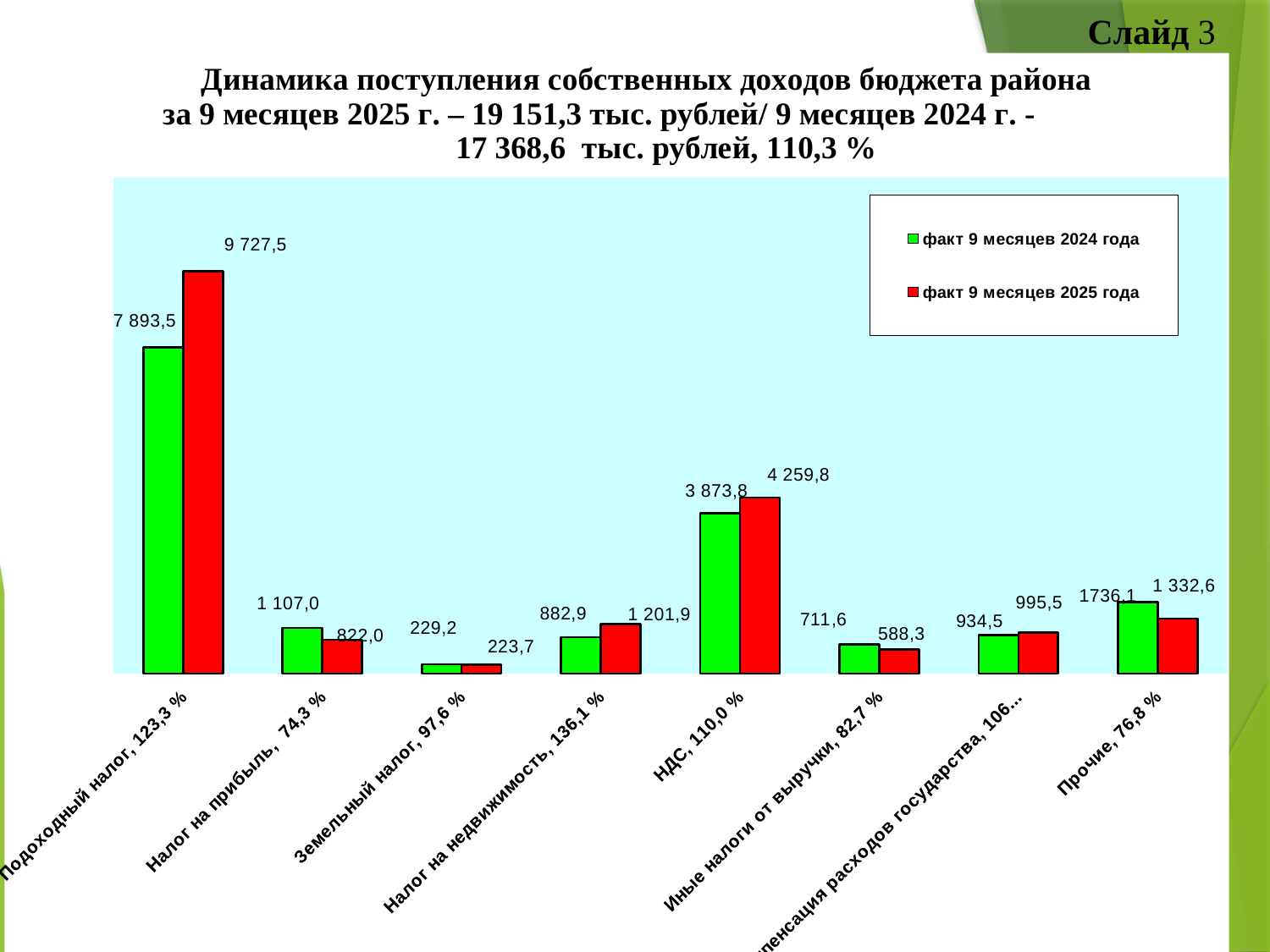
What is the difference between the 2025 and 2024 values for "Подоходный налог"? 1 834,0 Which category has the highest value for "факт 9 месяцев 2025 года"? Подоходный налог Which colour represents "факт 9 месяцев 2025 года" in the chart? Red Which category has the lowest value for "факт 9 месяцев 2024 года"? Земельный налог What is the value of "факт 9 месяцев 2024 года" for "НДС"? 3 873,8 How many categories are shown on the x axis of the chart? 8 How many series does the legend list? 2 For "Налог на прибыль", which is larger: the value for "факт 9 месяцев 2024 года" or "факт 9 месяцев 2025 года"? факт 9 месяцев 2024 года What is the value of "факт 9 месяцев 2025 года" for "Налог на недвижимость"? 1 201,9 What type of chart is shown on the slide? Bar chart What is the value of "факт 9 месяцев 2025 года" for "Подоходный налог"? 9 727,5 What is the value of "факт 9 месяцев 2024 года" for "Иные налоги от выручки"? 711,6